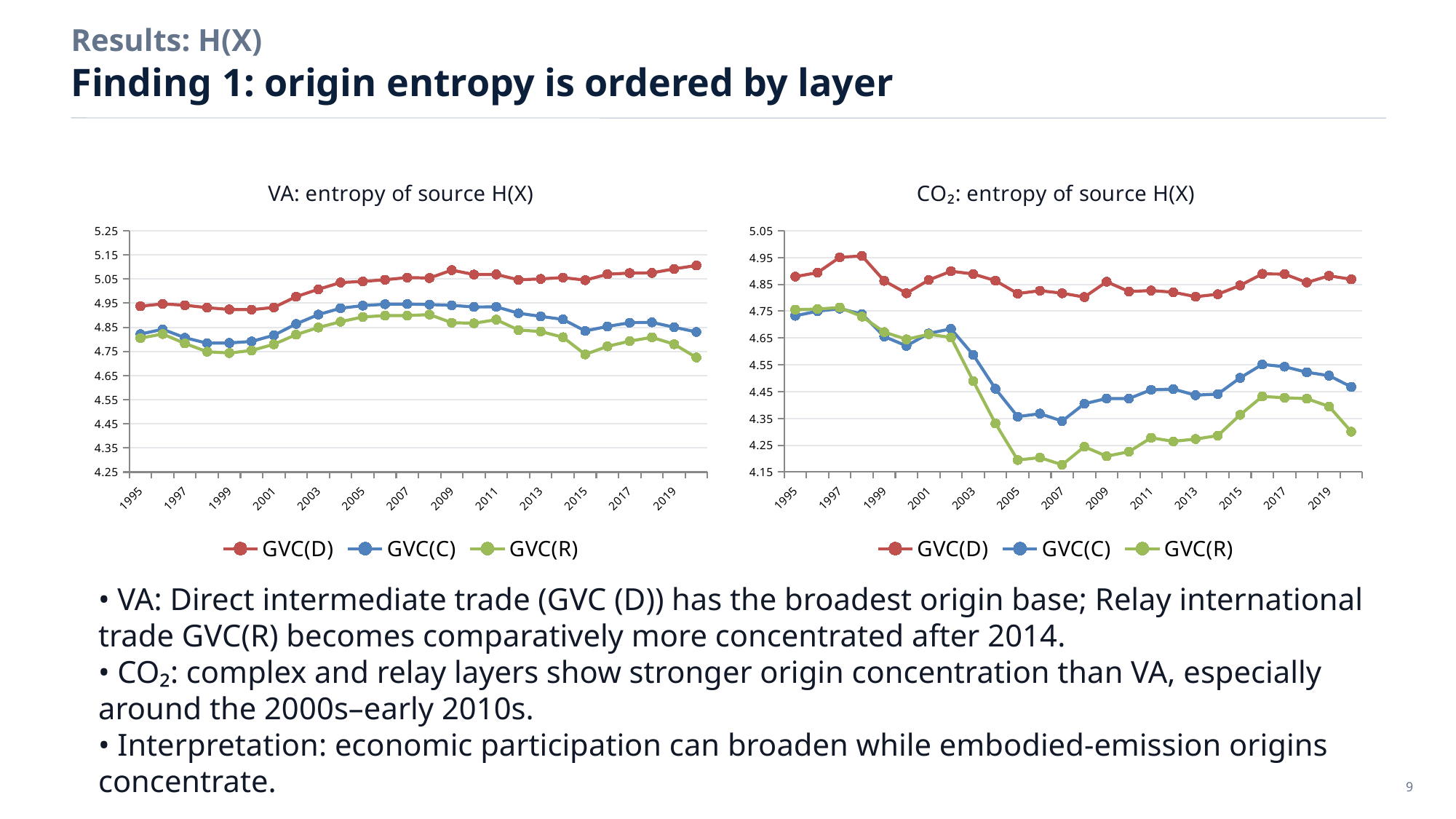
In the 'CO₂: entropy of source H(X)' chart, does the GVC(R) series rise or fall between 2002 and 2005? fall What is the title of the right-hand chart on the slide? CO₂: entropy of source H(X) How many series does the legend of the 'CO₂: entropy of source H(X)' chart list? 3 In the 'VA: entropy of source H(X)' chart, which series has the highest values throughout the period? GVC(D) In the 'CO₂: entropy of source H(X)' chart, is the value for GVC(C) in 2005 greater or less than 4.45? less In the 'VA: entropy of source H(X)' chart, which series has the lowest values throughout the period? GVC(R) What kind of chart is the 'VA: entropy of source H(X)' chart? line chart How many data points does each series have in the 'VA: entropy of source H(X)' chart? 26 In the 'CO₂: entropy of source H(X)' chart, is the value for GVC(D) in 1998 greater or less than 4.85? greater In the 'CO₂: entropy of source H(X)' chart, which is larger in 2007, GVC(C) or GVC(R)? GVC(C) In the 'CO₂: entropy of source H(X)' chart, is the value for GVC(R) in 2007 greater or less than 4.25? less